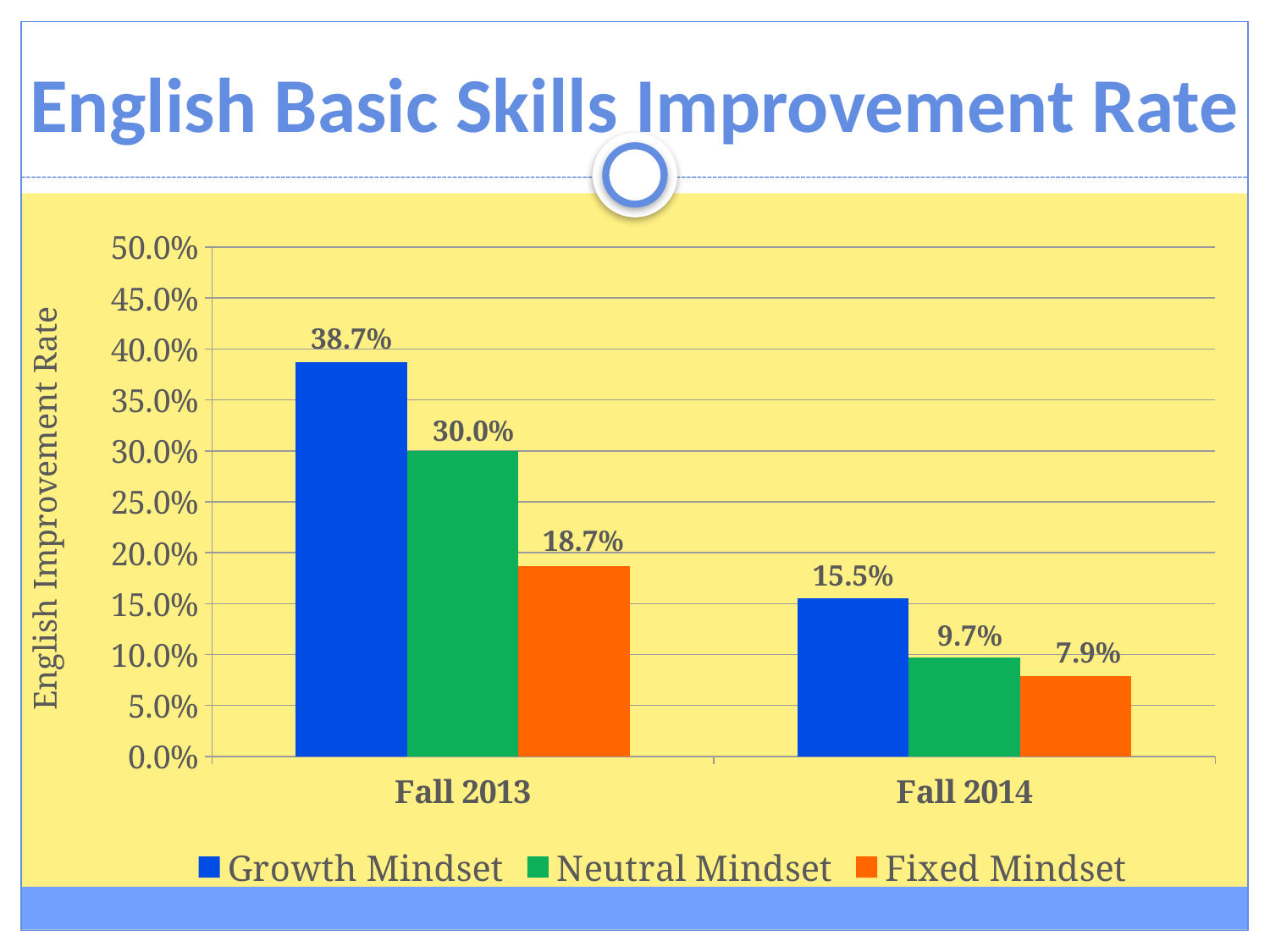
What kind of chart is shown on the slide? Bar chart What is the English improvement rate for Fixed Mindset in Fall 2014? 7.9% How many series does the legend list? 3 What is the difference between the Growth Mindset and Fixed Mindset improvement rates in Fall 2013? 20.0% Do the Growth Mindset improvement rates rise or fall from Fall 2013 to Fall 2014? Fall What is the difference between the Growth Mindset improvement rate in Fall 2013 and in Fall 2014? 23.2% Which mindset group has the lowest improvement rate in Fall 2014? Fixed Mindset What is the English improvement rate for Neutral Mindset in Fall 2014? 9.7% Which is larger: the Neutral Mindset rate in Fall 2013 or the Growth Mindset rate in Fall 2014? Neutral Mindset rate in Fall 2013 What is the English improvement rate for Growth Mindset in Fall 2013? 38.7% Which mindset group has the highest improvement rate in Fall 2013? Growth Mindset Is the Fixed Mindset improvement rate in Fall 2013 greater or less than 20.0%? less